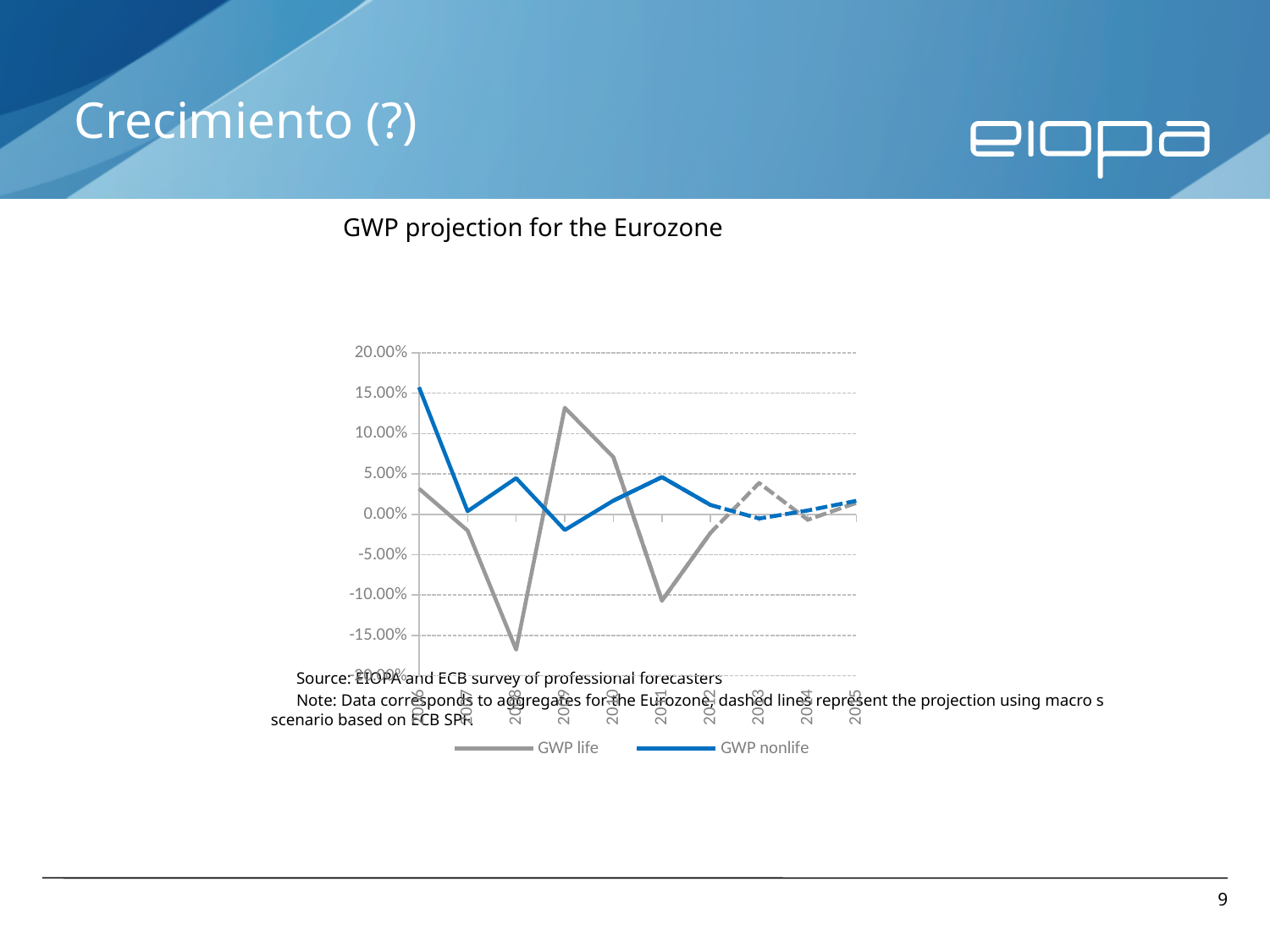
Which series has the larger value in 2006, GWP life or GWP nonlife? GWP nonlife How many years are shown on the x axis? 10 What kind of chart is shown on the slide? line chart In which year does GWP nonlife reach its highest value? 2006 In which year does GWP life reach its lowest value? 2008 Is the value for GWP life in 2008 greater or less than -15.00%? less In which year does GWP life reach its highest value? 2009 According to the note, what do the dashed lines represent? the projection using macro scenario based on ECB SPF Is the value for GWP nonlife in 2009 greater or less than 0.00%? less How many series does the legend list? 2 Which series has the larger value in 2009, GWP life or GWP nonlife? GWP life Is the value for GWP life in 2009 greater or less than 10.00%? greater